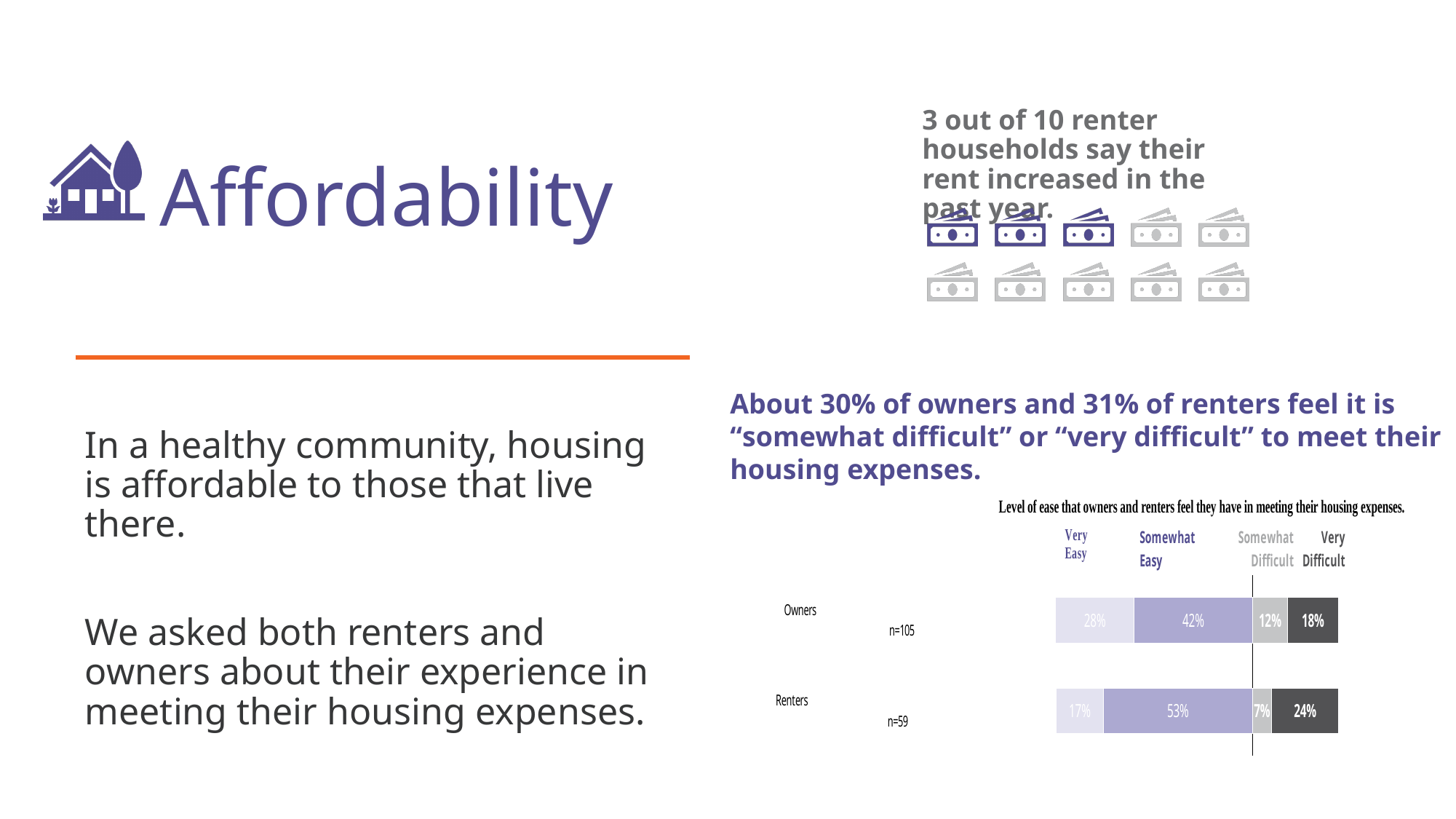
What percentage of renters say it is "Very Difficult" to meet their housing expenses? 24% What percentage of owners say it is "Somewhat Difficult" to meet their housing expenses? 12% What percentage of renters say it is "Somewhat Easy" to meet their housing expenses? 53% Which group has a larger "Very Easy" share, owners or renters? Owners What is the difference between the "Very Difficult" shares for renters and owners? 6% What is the sample size (n) for the Owners group in the chart? n=105 Which response category has the smallest share among renters? Somewhat Difficult How many response categories does the chart show for each group? 4 Which response category has the largest share among renters? Somewhat Easy What percentage of owners say it is "Very Easy" to meet their housing expenses? 28% What is the title of the chart on the slide? Level of ease that owners and renters feel they have in meeting their housing expenses. What type of chart is used to show the level of ease in meeting housing expenses? Stacked bar chart